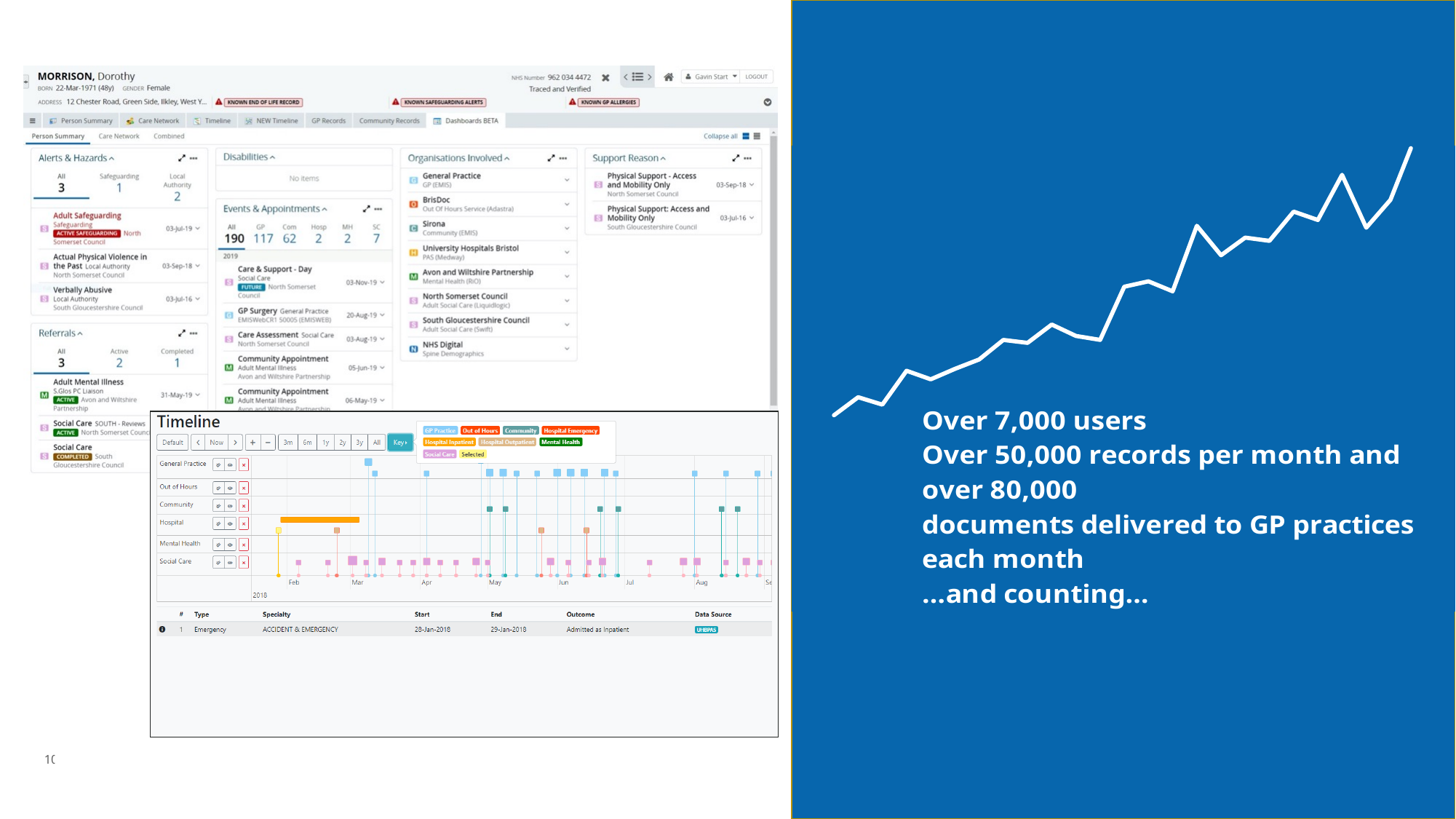
On the line chart on the right side of the slide, do the values generally rise or fall from left to right? rise What kind of chart is shown on the blue panel on the right side of the slide? line chart In the Timeline chart on the left, what is the first month label shown on the x axis? Feb What colour is the line in the chart on the right side of the slide? white In the Timeline chart on the left, which row contains the long orange horizontal bar? Hospital In the Timeline chart on the left, how many category rows are listed down the left side? 6 In the Timeline chart on the left, which year is shown beneath the month labels on the x axis? 2018